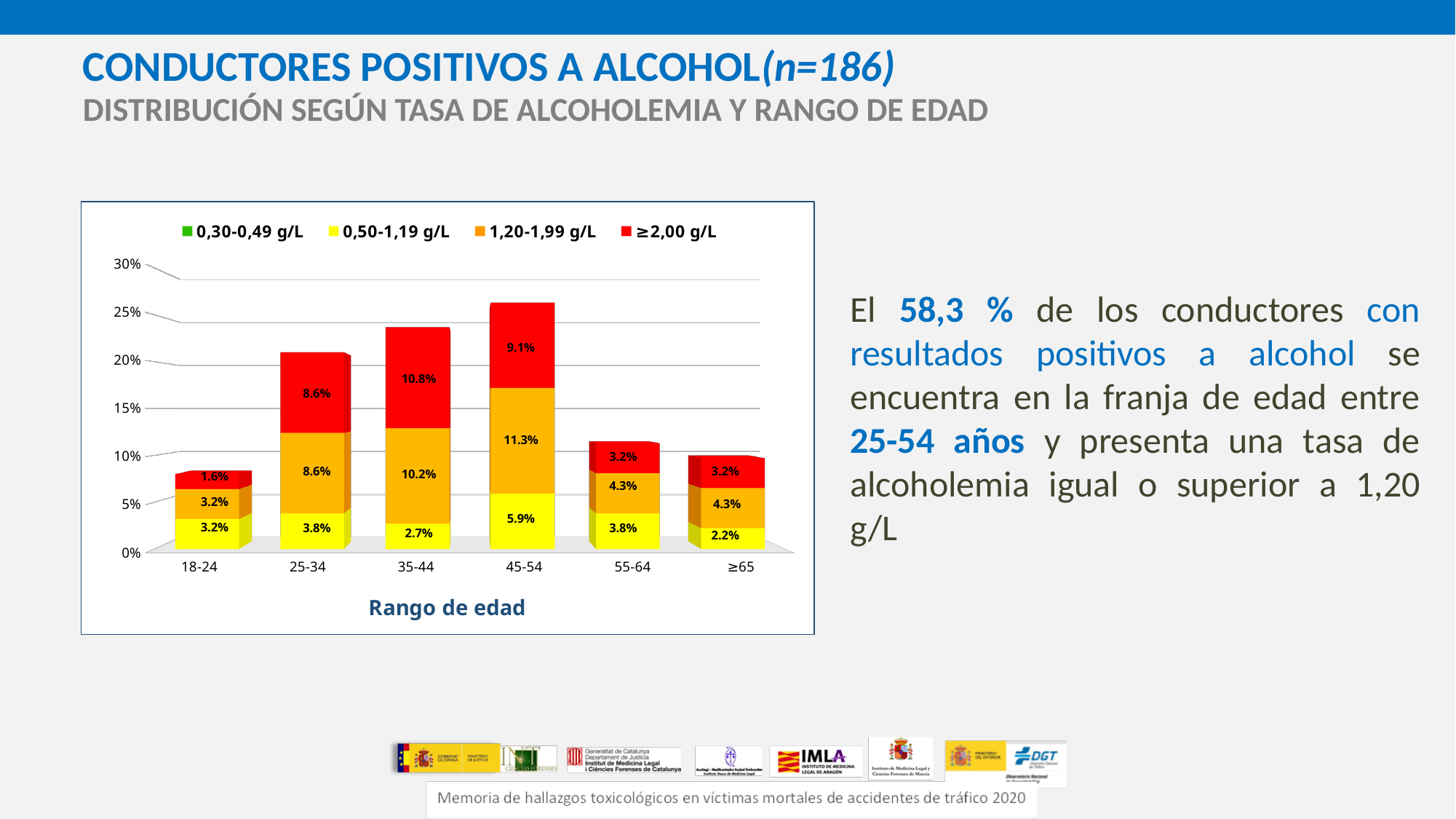
Is the total stacked value for the 35-44 age range greater or less than 20%? greater Which is larger: the ≥2,00 g/L value for 25-34 or for 45-54? 45-54 What is the value for the 0,50-1,19 g/L series in the ≥65 age range? 2.2% What is the value for the ≥2,00 g/L series in the 35-44 age range? 10.8% What kind of chart is shown on the slide? Stacked bar chart How many series does the legend list? 4 What is the value for the ≥2,00 g/L series in the 18-24 age range? 1.6% What is the value for the 1,20-1,99 g/L series in the 45-54 age range? 11.3% How many age ranges are shown on the x axis? 6 Which age range has the tallest stacked bar overall? 45-54 Which age range has the shortest stacked bar overall? 18-24 What is the difference between the 1,20-1,99 g/L values for the 45-54 and 55-64 age ranges? 7.0%